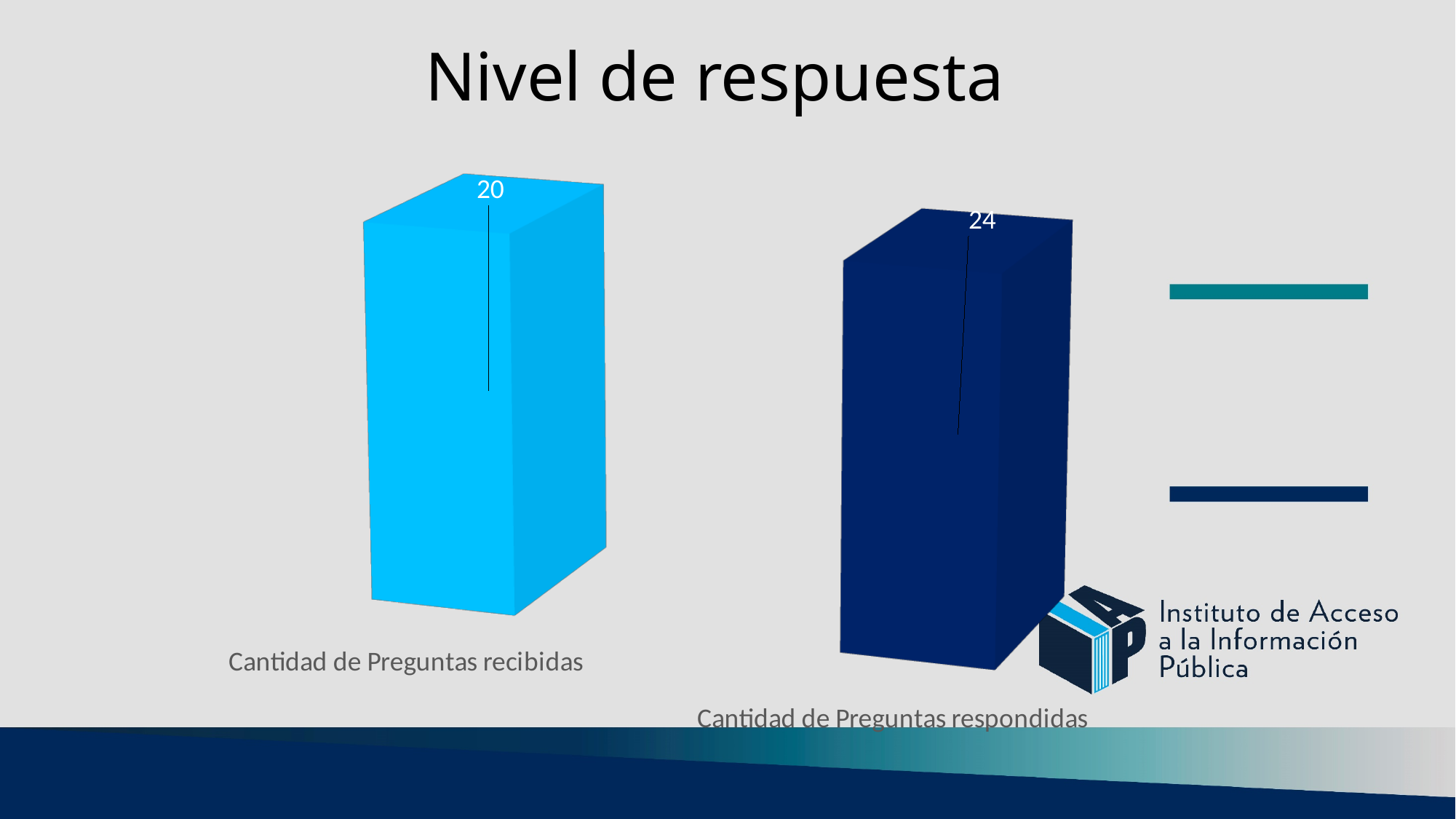
What is the value for Cantidad de Preguntas recibidas? 20 Which category has the lowest value? Cantidad de Preguntas recibidas What is the total of the two values shown in the chart? 44 What is the title of the slide? Nivel de respuesta Which category has the highest value? Cantidad de Preguntas respondidas How many categories are shown in the chart? 2 What is the difference between the values for Cantidad de Preguntas respondidas and Cantidad de Preguntas recibidas? 4 What is the value for Cantidad de Preguntas respondidas? 24 What kind of chart is shown on the slide? Bar chart Which is larger, the value for Cantidad de Preguntas recibidas or the value for Cantidad de Preguntas respondidas? Cantidad de Preguntas respondidas